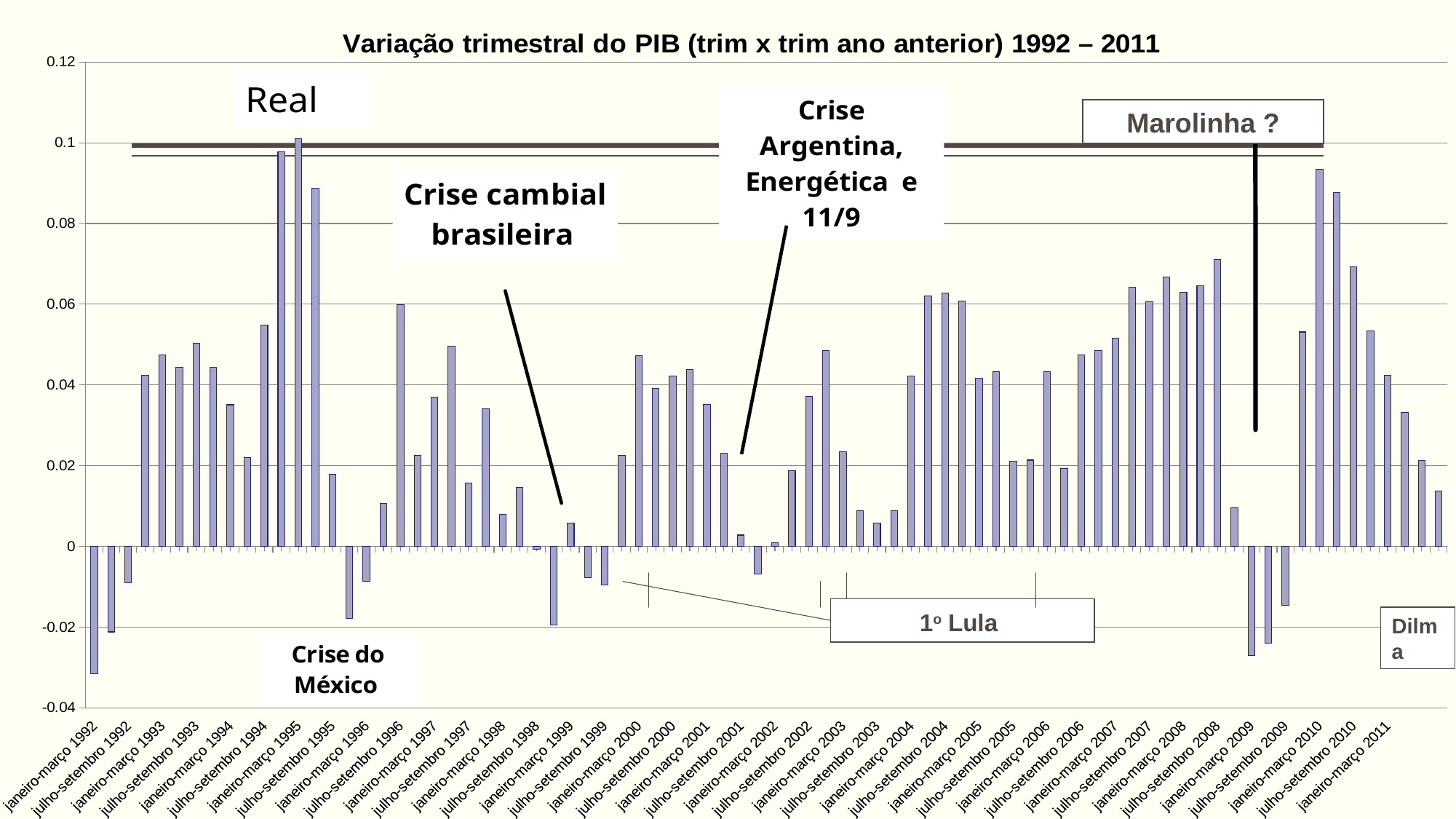
What kind of chart is shown on the slide? bar chart Is the value for janeiro-março 2009 greater or less than -0.02? less Which labelled quarter has the lowest value in the chart? janeiro-março 1992 Do the values rise or fall from janeiro-março 2010 to janeiro-março 2011? fall Is the value for janeiro-março 1992 greater or less than -0.02? less What is the title of the chart? Variação trimestral do PIB (trim x trim ano anterior) 1992 – 2011 Which labelled quarter has the highest value in the chart? janeiro-março 1995 Is the value for janeiro-março 1995 greater or less than 0.08? greater Which is larger, the value for janeiro-março 1993 or the value for janeiro-março 1994? janeiro-março 1993 Which is larger, the value for janeiro-março 1995 or the value for janeiro-março 2010? janeiro-março 1995